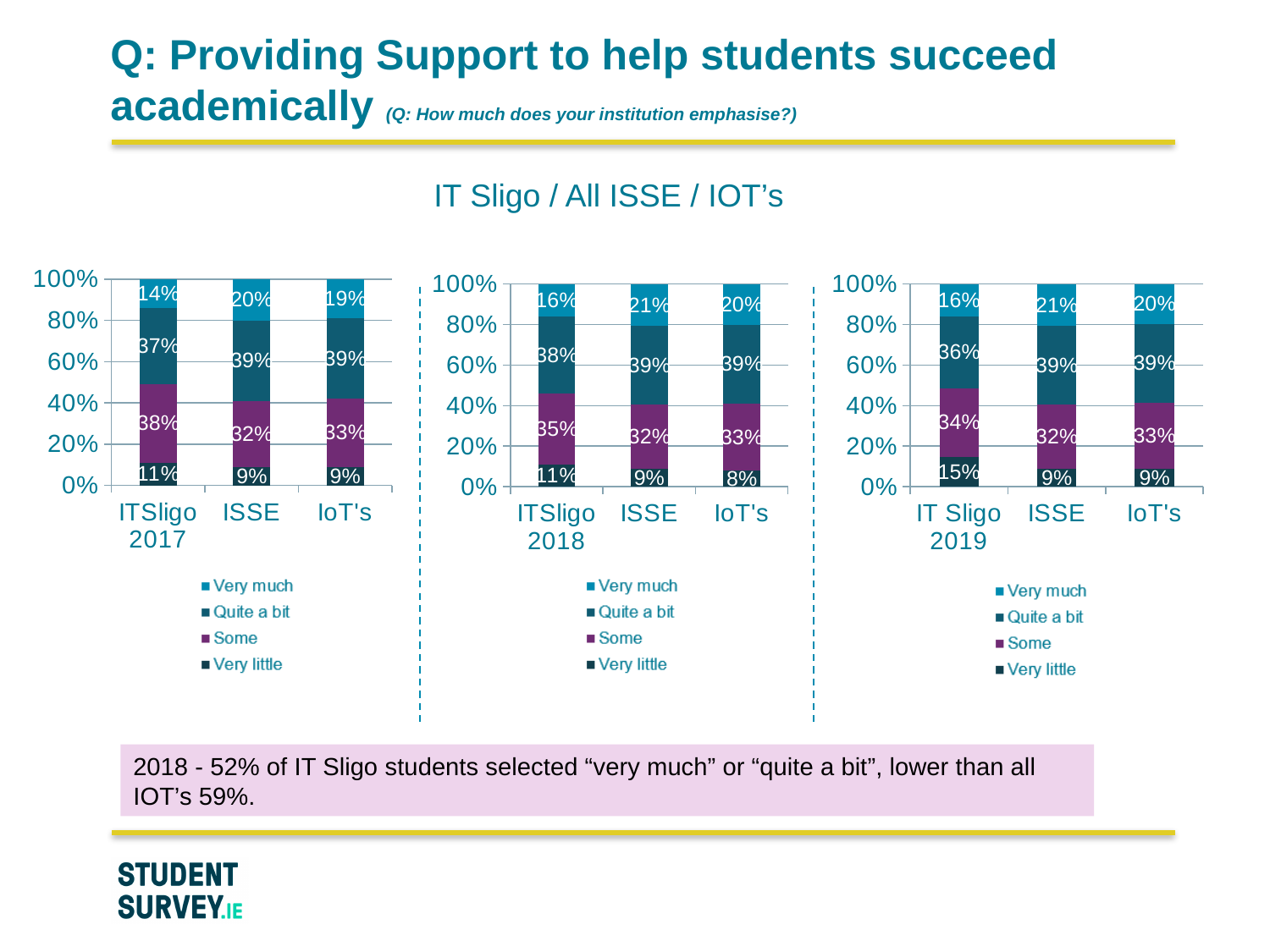
How many series does the legend of the left chart (2017) list? 4 In the left chart (2017), which category has the lowest "Very much" value? ITSligo In the middle chart (2018), what is the difference between the "Very much" values for ISSE and ITSligo? 5% In the middle chart (2018), what is the "Very little" value for IoT's? 8% In the right chart (2019), is the "Very little" value larger for IT Sligo or for ISSE? IT Sligo In the right chart (2019), what is the "Quite a bit" value for IT Sligo? 36% In the right chart (2019), what percentage of IT Sligo students selected "Very little"? 15% How many categories are shown on the x axis of the right chart (2019)? 3 In the left chart (2017), what is the "Some" value for ISSE? 32% In the middle chart (2018), which category has the highest "Very much" value? ISSE What kind of chart is the middle chart (2018)? Stacked bar chart In the left chart (2017), what percentage of ITSligo students selected "Very much"? 14%